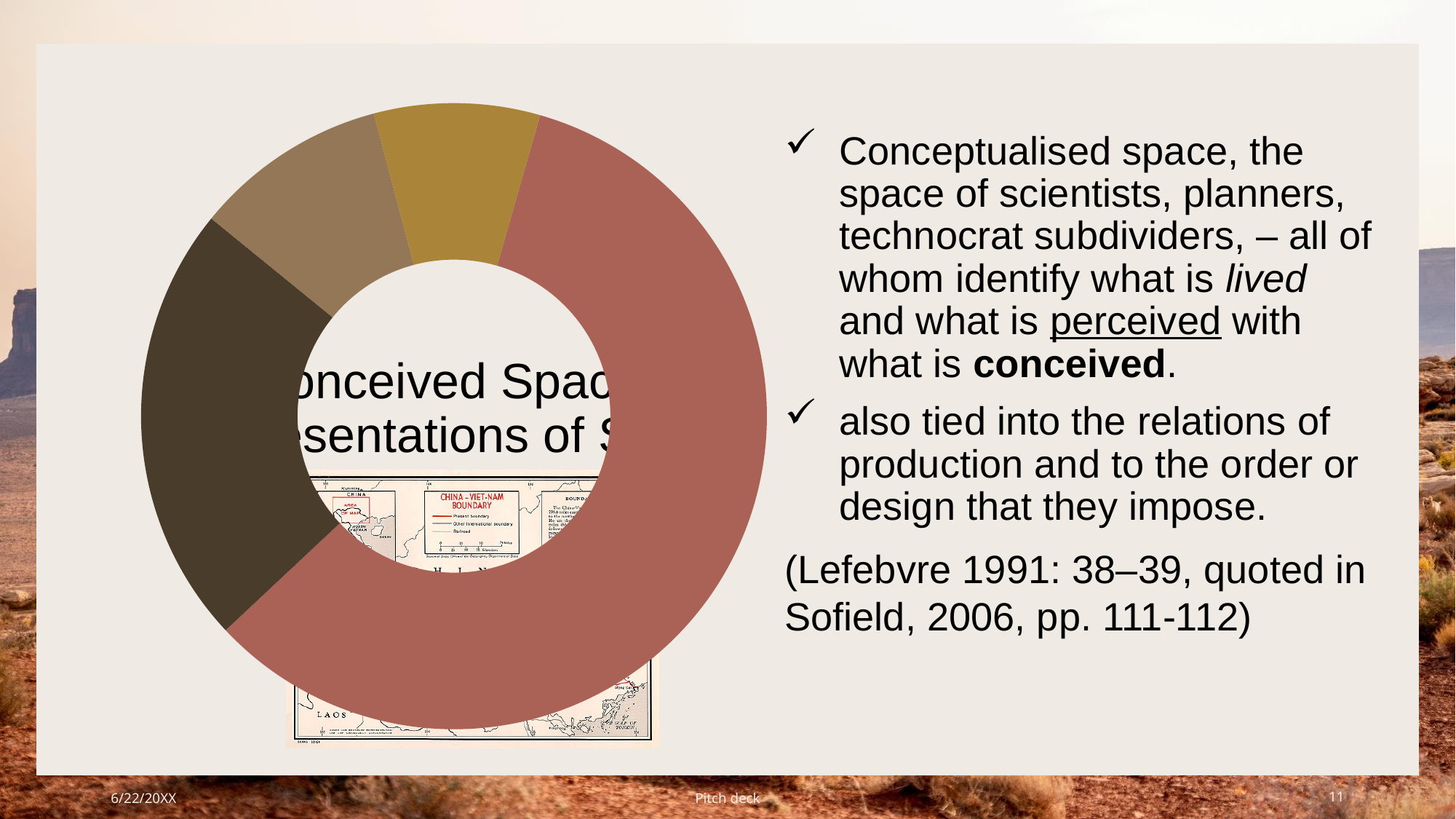
Which slice of the doughnut chart is the largest? The reddish-brown slice Which is larger in the doughnut chart, the dark brown slice or the gold slice? The dark brown slice Does the doughnut chart display a legend? No Which is larger in the doughnut chart, the reddish-brown slice or the dark brown slice? The reddish-brown slice Does the reddish-brown slice take up more or less than half of the doughnut chart? More How many slices does the doughnut chart have? 4 What kind of chart is shown on the left of the slide? Doughnut chart Are data labels shown on the slices of the doughnut chart? No